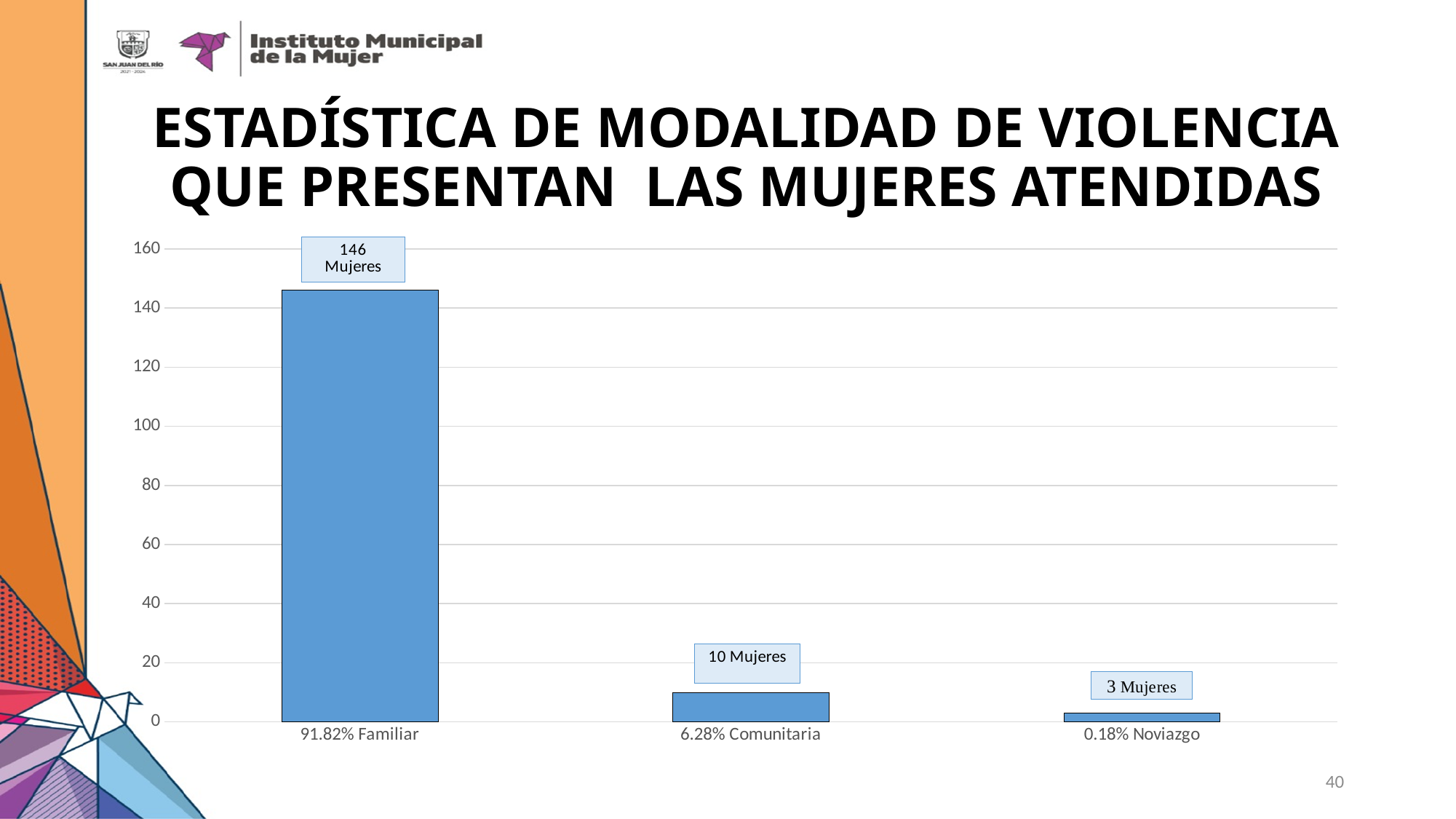
How many women are shown for the Noviazgo category? 3 Mujeres How many women are shown for the Comunitaria category? 10 Mujeres What percentage is shown in the x-axis label for the Comunitaria category? 6.28% What kind of chart is shown on the slide? Bar chart Which is larger, the value for Comunitaria or the value for Noviazgo? Comunitaria How many categories are shown on the x axis? 3 Is the value for Familiar greater or less than 140? greater How many women are shown for the Familiar category? 146 Mujeres Which category has the lowest value? 0.18% Noviazgo What is the difference between the Familiar and Comunitaria values? 136 What is the difference between the Comunitaria and Noviazgo values? 7 Which category has the highest value? 91.82% Familiar